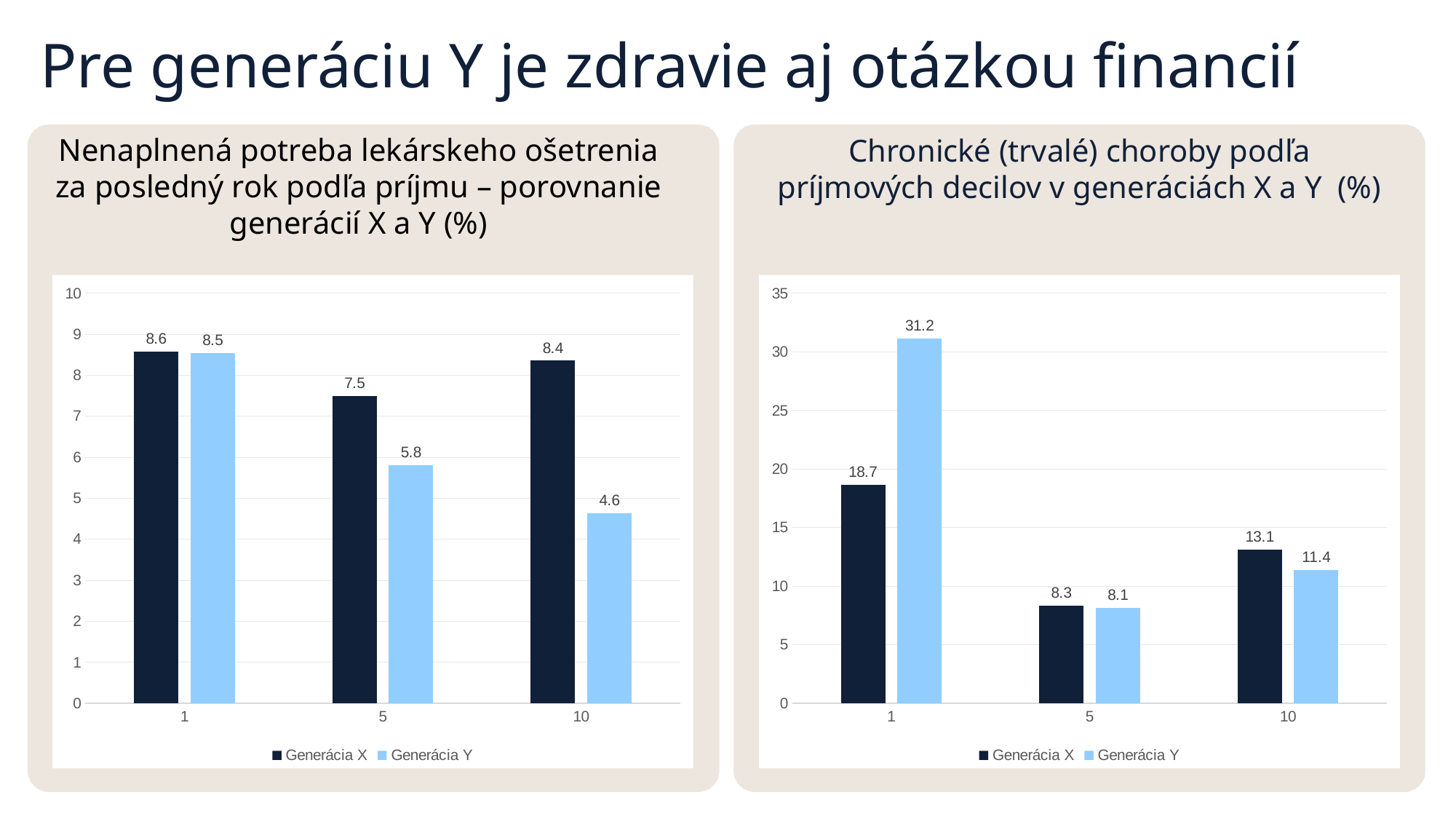
How many series does the legend of the right chart (Chronické choroby) list? 2 In the left chart (Nenaplnená potreba lekárskeho ošetrenia), what is the value for Generácia Y at category 5? 5.8 In the left chart (Nenaplnená potreba lekárskeho ošetrenia), do the Generácia Y values rise or fall from category 1 to category 10? fall What kind of chart is the left chart (Nenaplnená potreba lekárskeho ošetrenia)? bar chart In the left chart (Nenaplnená potreba lekárskeho ošetrenia), which category has the lowest value for Generácia Y? 10 In the left chart (Nenaplnená potreba lekárskeho ošetrenia), what is the value for Generácia X at category 10? 8.4 In the right chart (Chronické choroby), which category has the highest value for Generácia Y? 1 In the right chart (Chronické choroby), what is the value for Generácia Y at category 1? 31.2 In the right chart (Chronické choroby), which is larger at category 10: Generácia X or Generácia Y? Generácia X In the right chart (Chronické choroby), what is the difference between Generácia Y and Generácia X at category 1? 12.5 In the right chart (Chronické choroby), what is the value for Generácia X at category 10? 13.1 In the left chart (Nenaplnená potreba lekárskeho ošetrenia), what is the difference between Generácia X and Generácia Y at category 10? 3.8